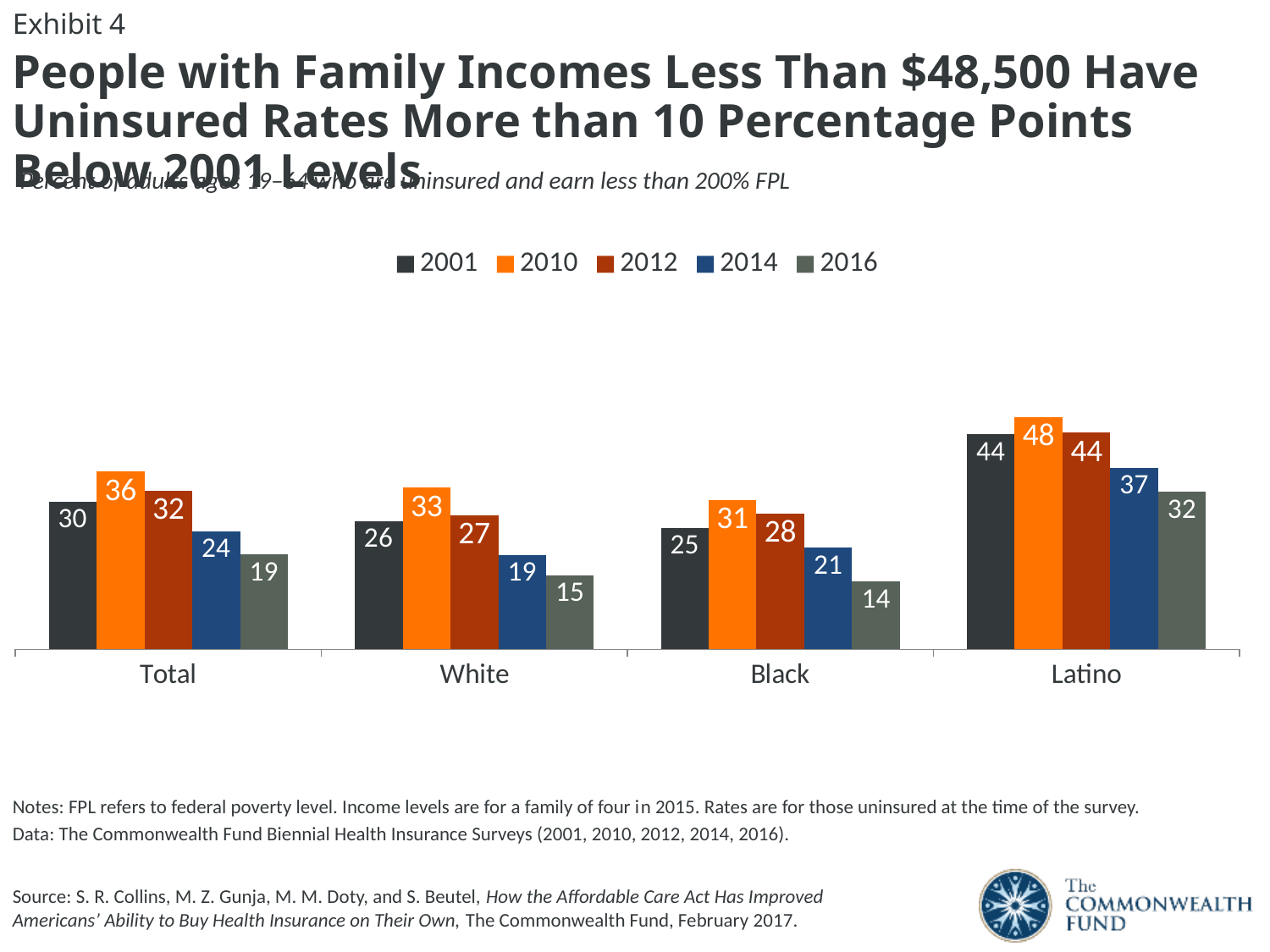
How many categories are shown on the x axis? 4 What is the difference between the 2001 and 2016 values for Total? 11 Which category has the lowest value in 2014? White What kind of chart is shown on the slide? Bar chart What is the value for Latino in 2010? 48 Which year is shown in orange in the legend? 2010 Which is larger, the 2012 value for White or the 2012 value for Black? Black How many series does the legend list? 5 Which category has the highest value in 2016? Latino What is the value for Total in 2001? 30 What is the value for Black in 2016? 14 For Latino, do the values rise or fall from 2010 to 2016? Fall